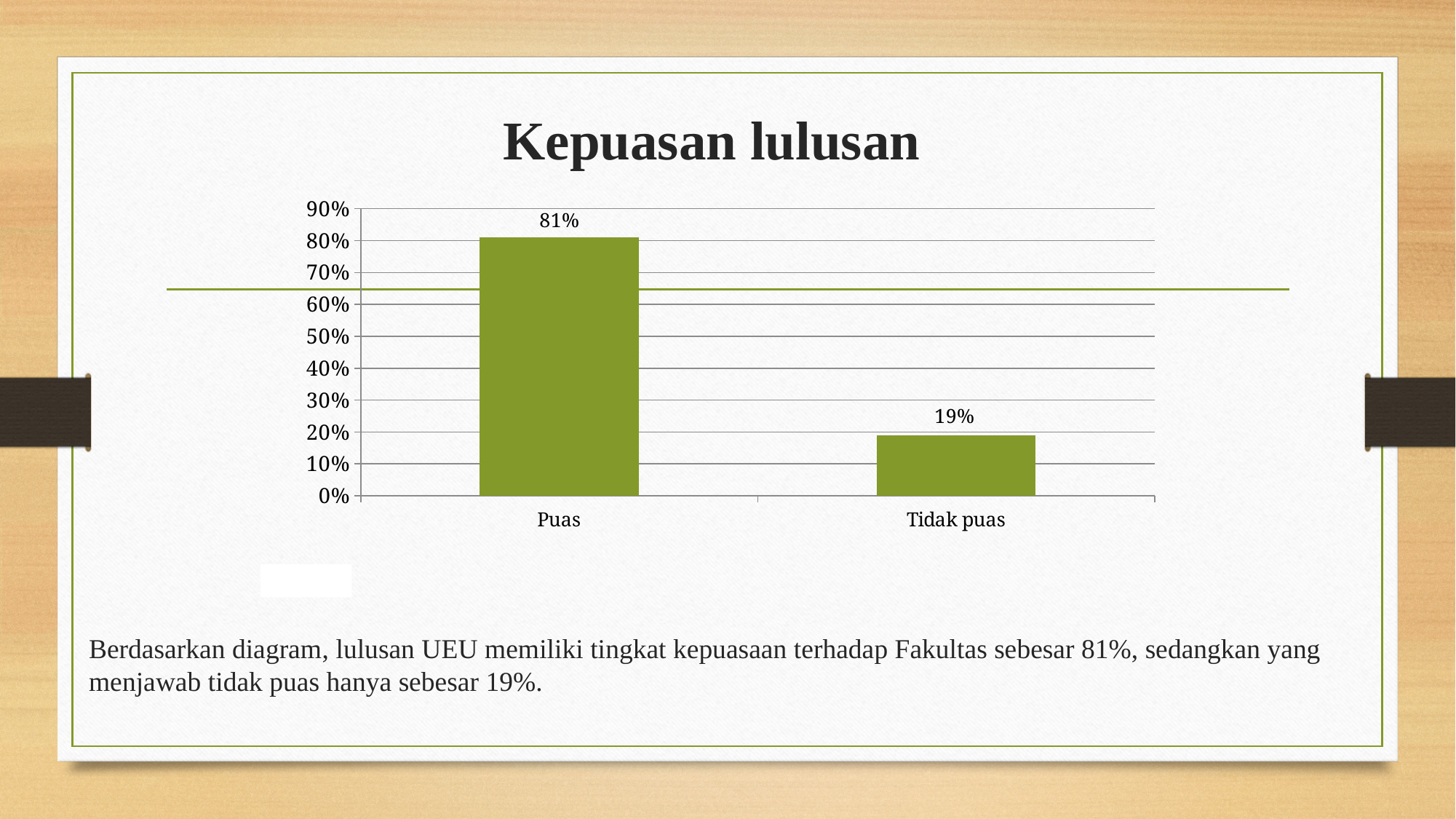
What is the value for Tidak puas? 19% Which category has the highest value? Puas What kind of chart is shown on the slide? bar chart What is the title of the chart? Kepuasan lulusan How many categories are shown on the x axis? 2 What is the difference between the values for Puas and Tidak puas? 62% What is the highest value shown on the y axis? 90% Which category has the lowest value? Tidak puas Is the value for Puas greater or less than 70%? greater Is the value for Tidak puas greater or less than 30%? less Which is larger, the value for Puas or the value for Tidak puas? Puas What is the value for Puas? 81%